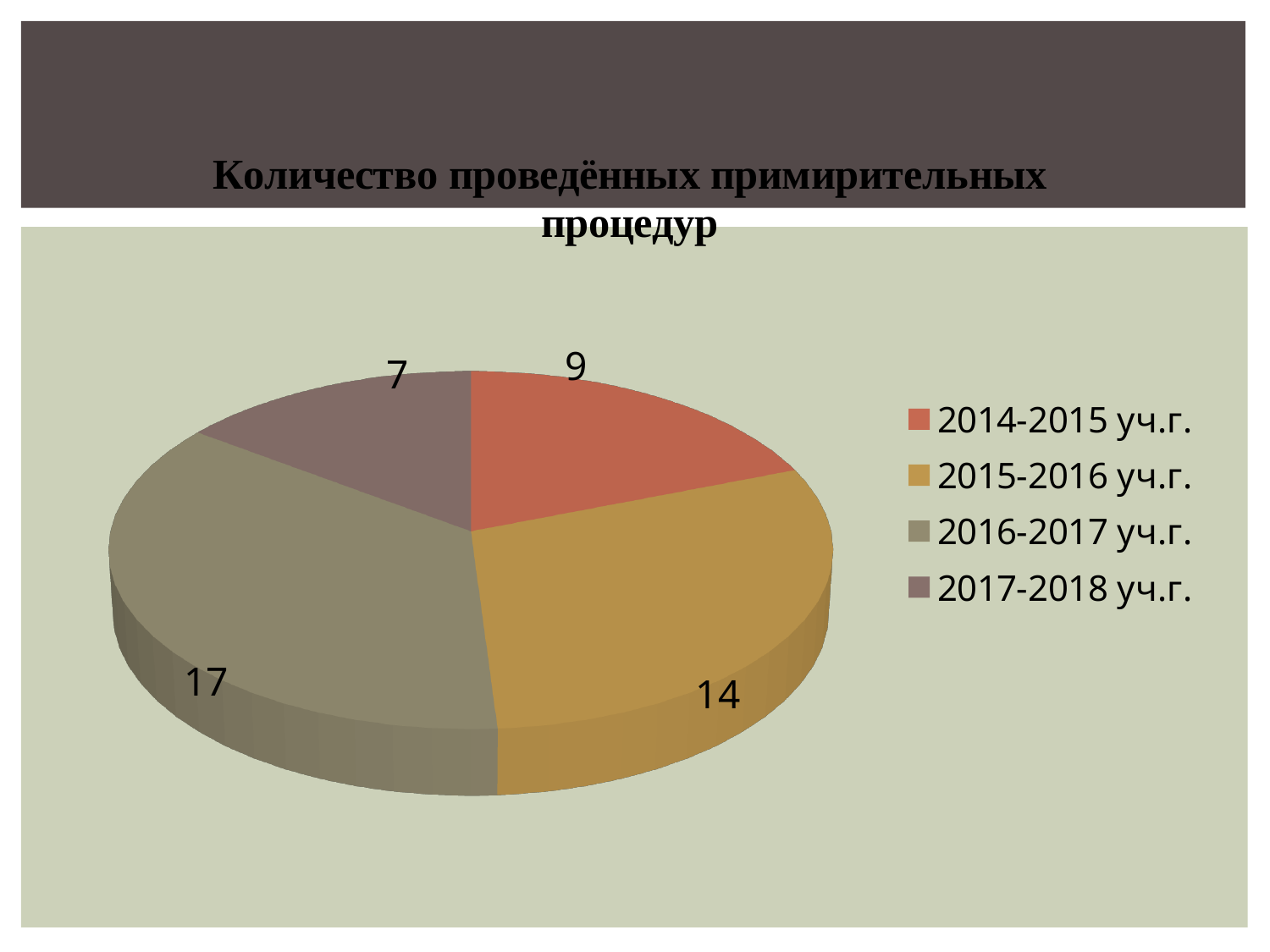
How many slices does the pie chart have? 4 What is the value for 2014-2015 уч.г.? 9 Which academic year has the lowest number of conciliation procedures? 2017-2018 уч.г. What is the value for 2015-2016 уч.г.? 14 Which academic year has the highest number of conciliation procedures? 2016-2017 уч.г. What type of chart is shown on the slide? pie chart What is the difference between the values for 2016-2017 уч.г. and 2014-2015 уч.г.? 8 What is the value for 2016-2017 уч.г.? 17 What is the value for 2017-2018 уч.г.? 7 Which is larger, the value for 2015-2016 уч.г. or the value for 2017-2018 уч.г.? 2015-2016 уч.г. What is the total of all the values shown in the pie chart? 47 What is the title of the chart? Количество проведённых примирительных процедур